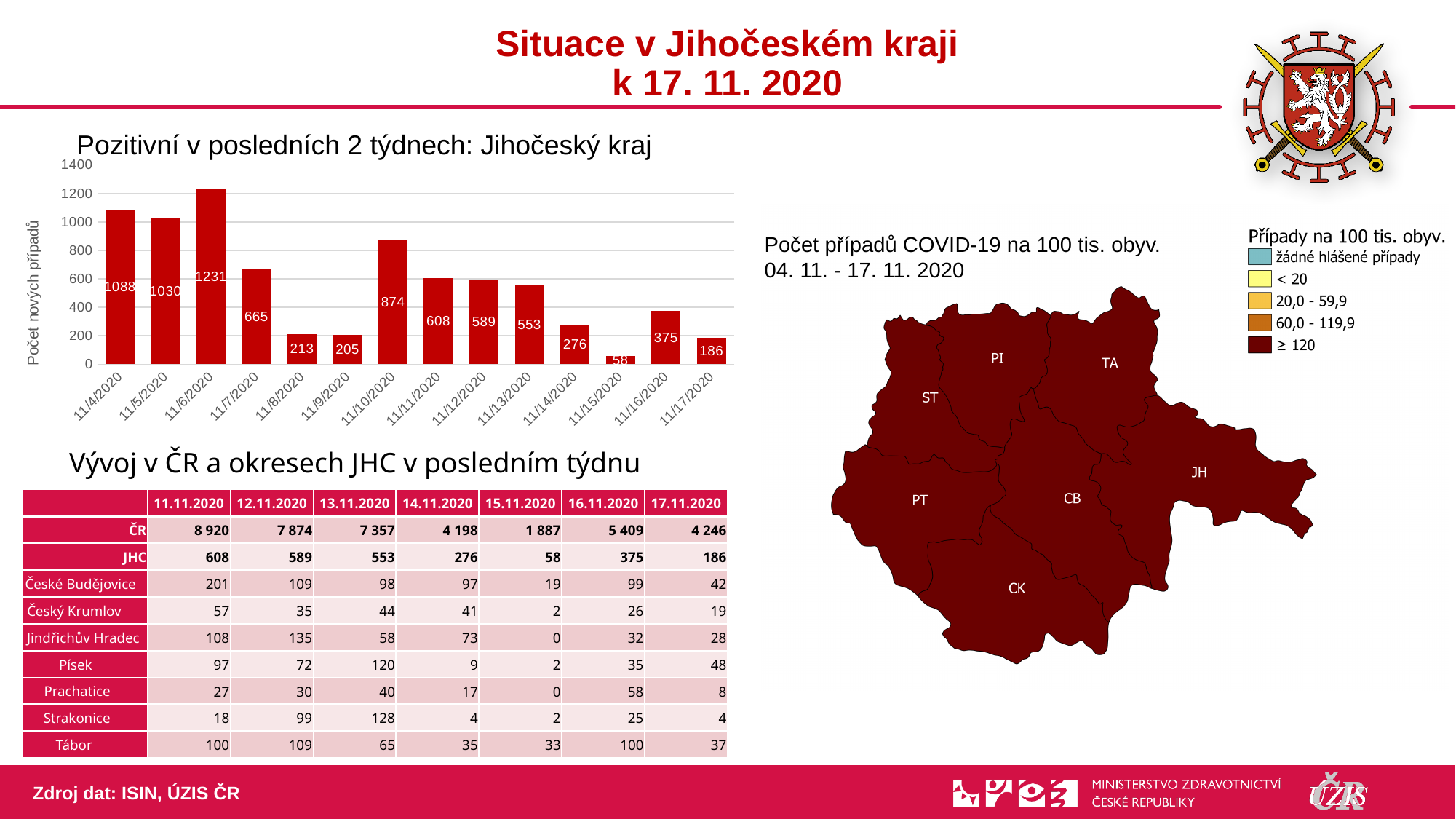
Overall, do the values in the bar chart rise or fall from 11/4/2020 to 11/17/2020? fall Which date has the highest bar in the bar chart? 11/6/2020 In the bar chart, what is the value for 11/17/2020? 186 In the bar chart, which is larger: the value for 11/16/2020 or the value for 11/14/2020? 11/16/2020 In the bar chart, what is the value for 11/6/2020? 1231 Which date has the lowest bar in the bar chart? 11/15/2020 What is the label on the vertical axis of the bar chart? Počet nových případů What type of chart is shown under the title 'Pozitivní v posledních 2 týdnech: Jihočeský kraj'? bar chart In the bar chart, what is the difference between the values for 11/4/2020 and 11/5/2020? 58 How many dates (bars) are shown in the bar chart? 14 In the bar chart, what is the value for 11/10/2020? 874 In the bar chart, what is the difference between the values for 11/10/2020 and 11/7/2020? 209